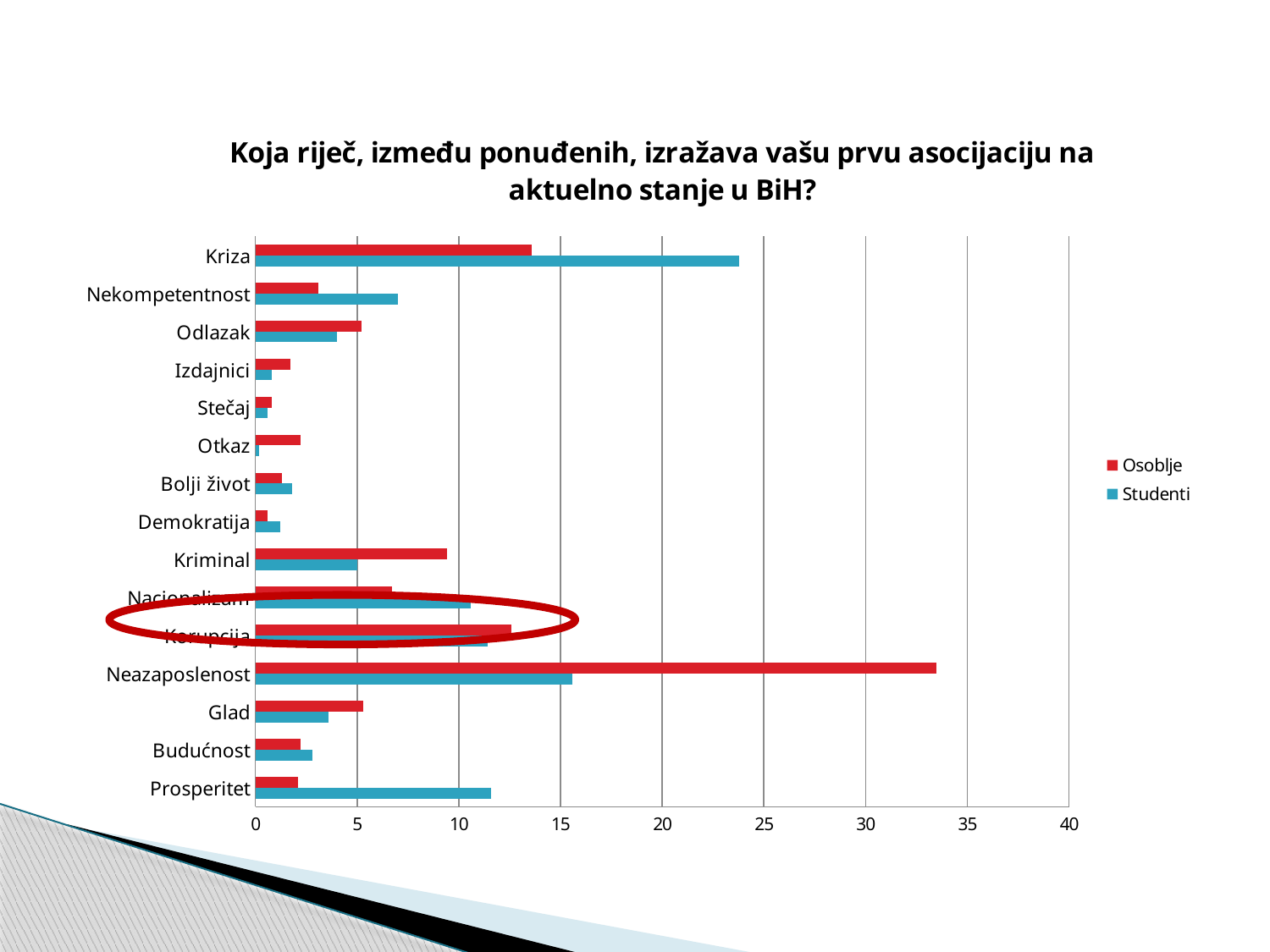
For Kriza, which series has the larger value, Osoblje or Studenti? Studenti How many categories are shown on the vertical axis of the chart? 15 What is the highest value shown on the horizontal axis of the chart? 40 How many series does the legend list? 2 Is the Studenti value for Prosperitet greater or less than 10? greater Is the Studenti value for Kriza greater or less than 20? greater Which series is shown in red in the chart? Osoblje Which category has the highest value for the Osoblje series? Neazaposlenost Which category has the highest value for the Studenti series? Kriza Is the Osoblje value for Neazaposlenost greater or less than 30? greater What kind of chart is shown on the slide? bar chart For Kriminal, which series has the larger value, Osoblje or Studenti? Osoblje